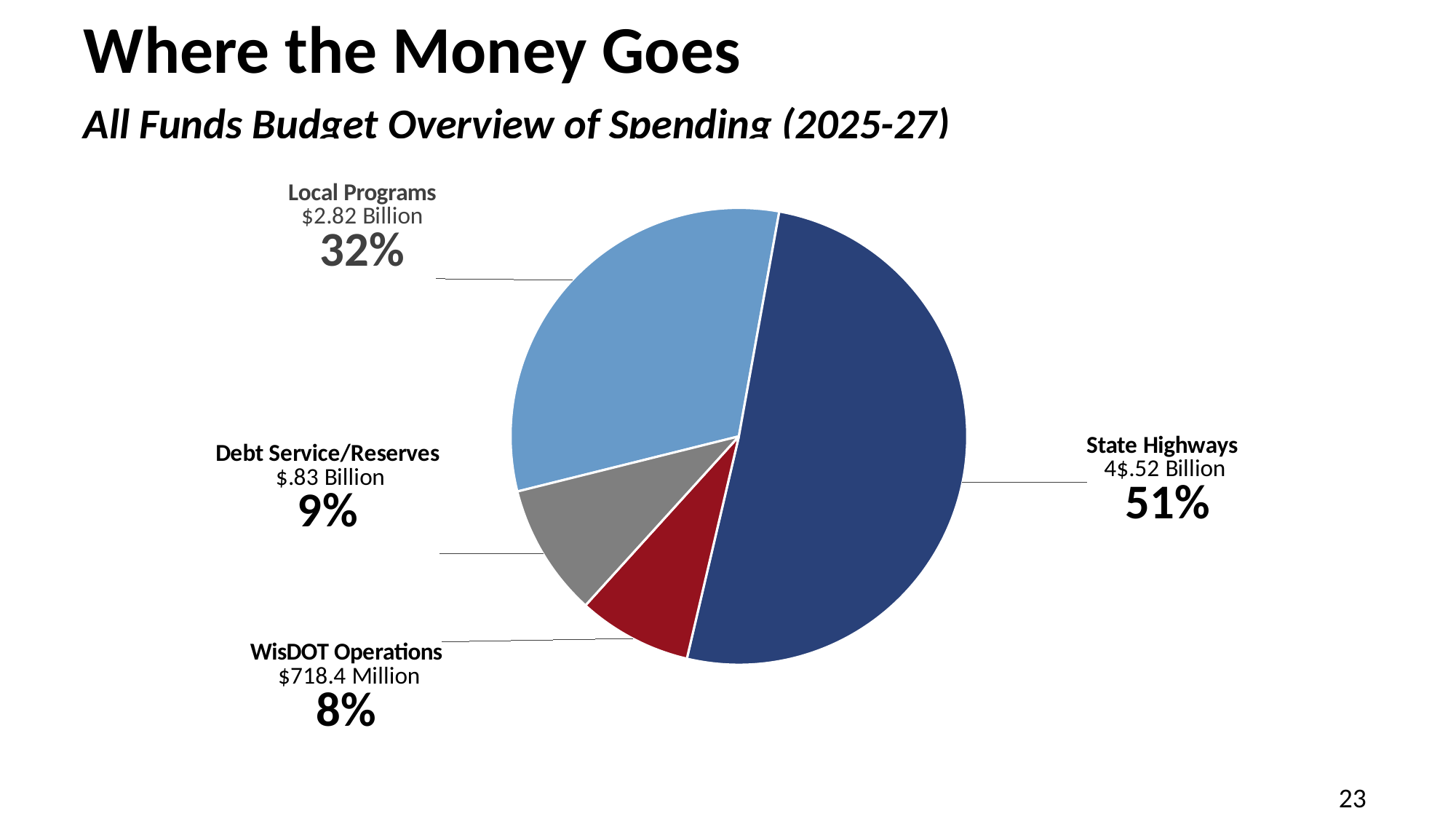
What is the difference in percentage points between State Highways and Local Programs? 19 percentage points Which category has the largest share of spending? State Highways What dollar amount is shown for WisDOT Operations? $718.4 Million What percentage share does State Highways have? 51% Which category has the smallest share of spending? WisDOT Operations What dollar amount is shown for Local Programs? $2.82 Billion What is the subtitle of the chart on the slide? All Funds Budget Overview of Spending (2025-27) What percentage share does Local Programs have? 32% What type of chart is shown on the slide? Pie chart What percentage share does Debt Service/Reserves have? 9% How many categories are shown in the pie chart? 4